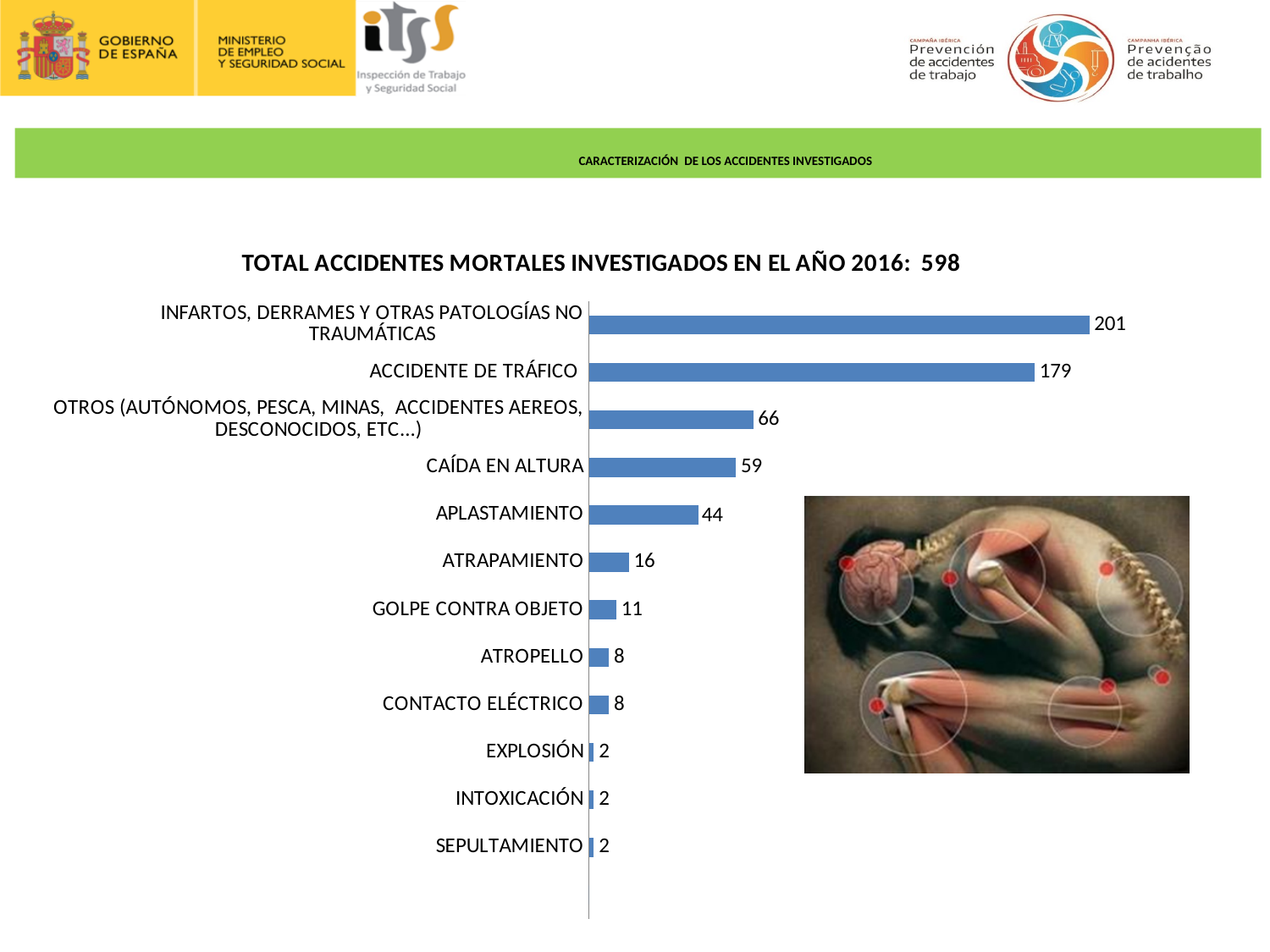
What is the value for ACCIDENTE DE TRÁFICO? 179 What is the difference between the values for INFARTOS, DERRAMES Y OTRAS PATOLOGÍAS NO TRAUMÁTICAS and ACCIDENTE DE TRÁFICO? 22 How many categories are shown in the chart? 12 What is the title of the chart? TOTAL ACCIDENTES MORTALES INVESTIGADOS EN EL AÑO 2016: 598 Which category has the highest value? INFARTOS, DERRAMES Y OTRAS PATOLOGÍAS NO TRAUMÁTICAS What is the value for CAÍDA EN ALTURA? 59 What is the value for ATROPELLO? 8 What is the value for APLASTAMIENTO? 44 What is the difference between the values for CAÍDA EN ALTURA and APLASTAMIENTO? 15 Which is larger, the value for ATRAPAMIENTO or the value for GOLPE CONTRA OBJETO? ATRAPAMIENTO What is the value for GOLPE CONTRA OBJETO? 11 What kind of chart is shown on the slide? Bar chart